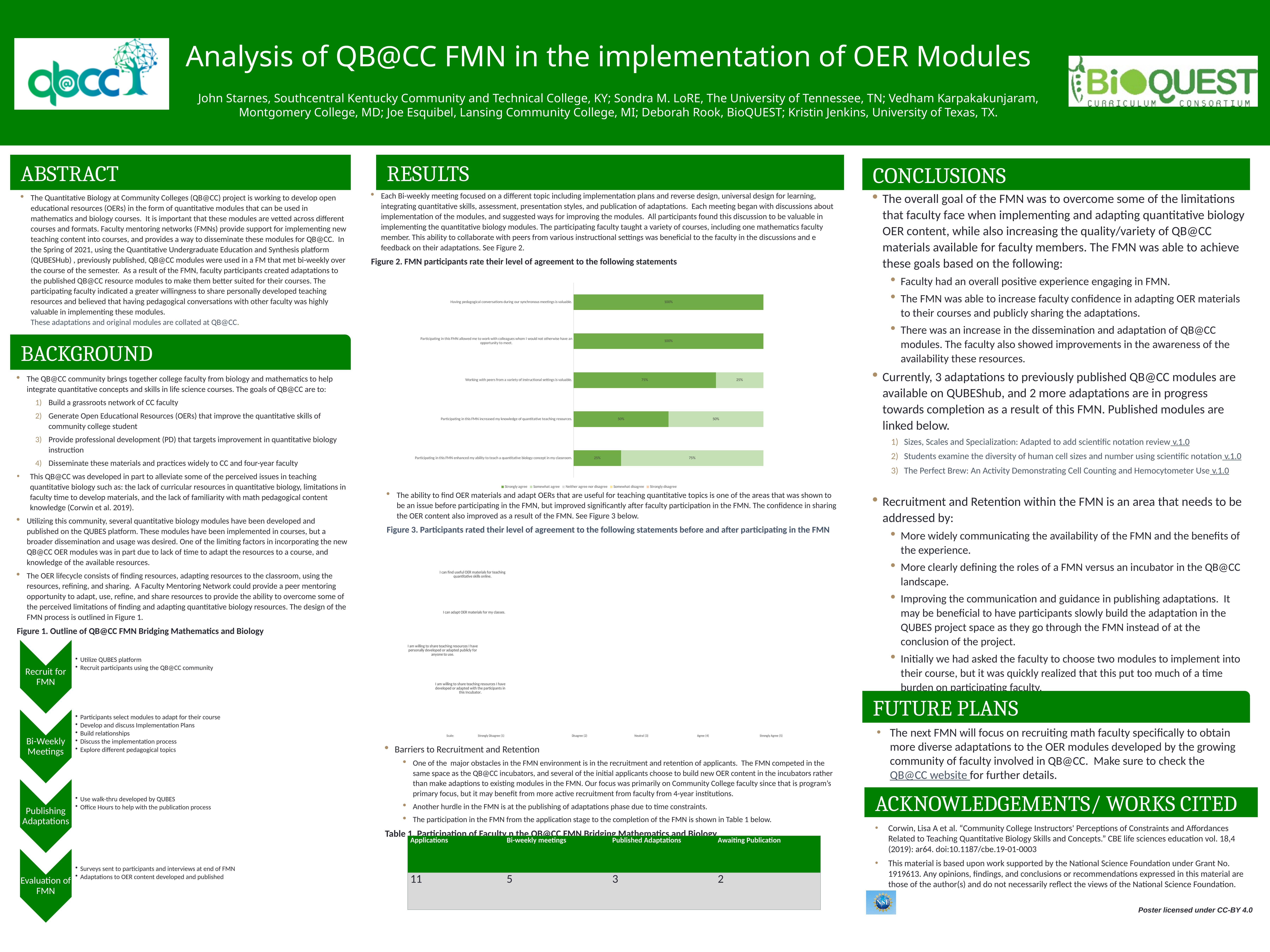
In Figure 2, what is the total of the 'Strongly agree' and 'Somewhat agree' percentages for 'Participating in this FMN increased my knowledge of quantitative teaching resources'? 100% What kind of chart is Figure 2? Stacked bar chart How many series does the legend of Figure 2 list? 5 In Figure 2, what is the difference between the 'Strongly agree' percentage for 'Working with peers from a variety of instructional settings is valuable' and the 'Strongly agree' percentage for 'Participating in this FMN enhanced my ability to teach a quantitative biology concept in my classroom'? 50% In Figure 2, what percentage somewhat agreed that participating in the FMN enhanced their ability to teach a quantitative biology concept in their classroom? 75% In Figure 2, which statement has the lowest 'Strongly agree' percentage? Participating in this FMN enhanced my ability to teach a quantitative biology concept in my classroom. In Figure 2, what percentage of participants strongly agreed that having pedagogical conversations during synchronous meetings is valuable? 100% In Figure 2, what percentage strongly agreed that working with peers from a variety of instructional settings is valuable? 75% How many statements are plotted in Figure 2? 5 What is the title of Figure 2? Figure 2. FMN participants rate their level of agreement to the following statements In Figure 2, what percentage strongly agreed that participating in the FMN increased their knowledge of quantitative teaching resources? 50% In Figure 2, which is larger: the 'Strongly agree' share for 'Working with peers from a variety of instructional settings is valuable' or the 'Strongly agree' share for 'Participating in this FMN increased my knowledge of quantitative teaching resources'? Working with peers from a variety of instructional settings is valuable.